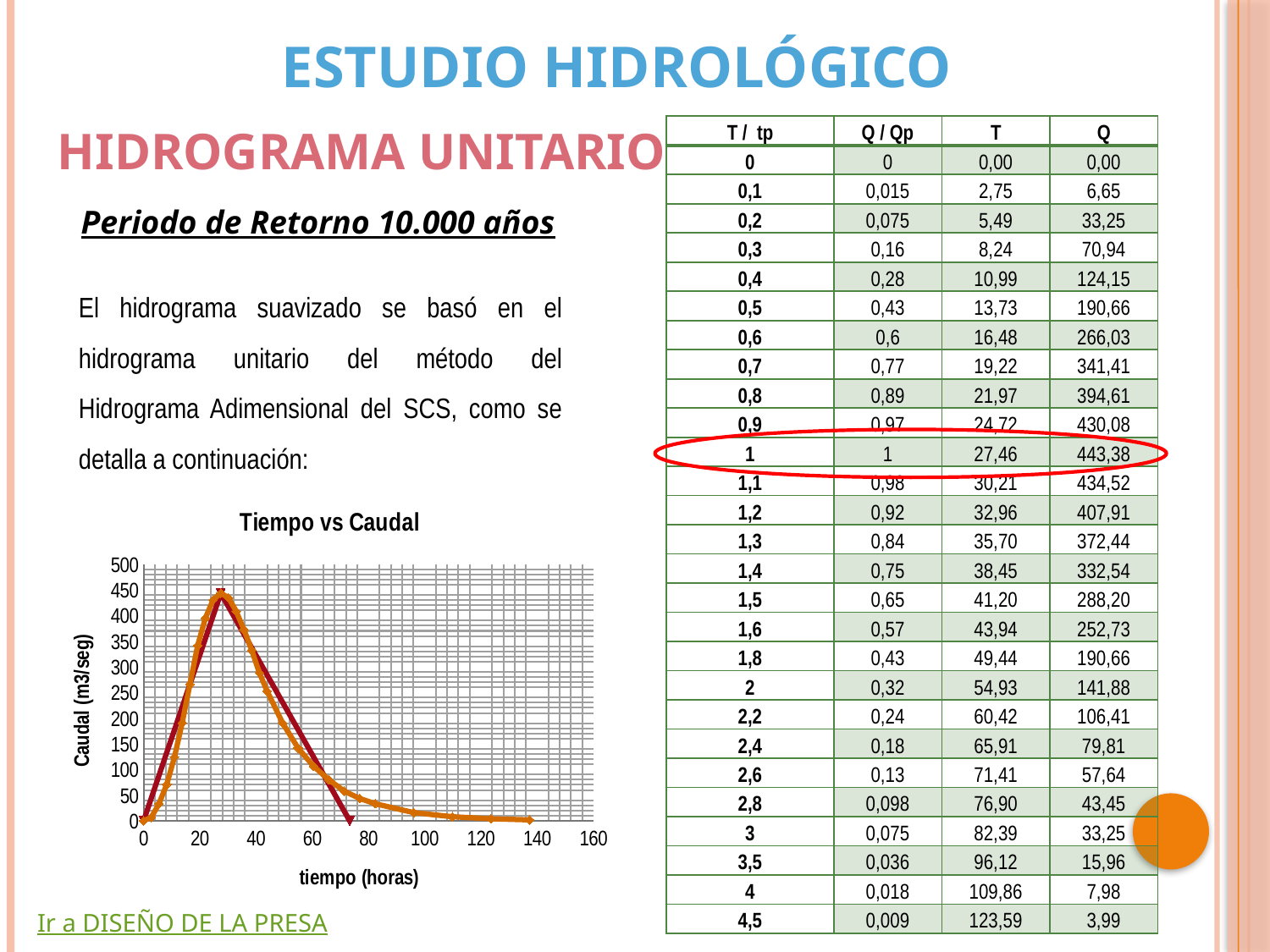
In the "Tiempo vs Caudal" chart, is the value of the orange curve at 100 hours greater or less than 50? less What is the highest tick value shown on the x axis of the "Tiempo vs Caudal" chart? 160 What kind of chart is "Tiempo vs Caudal"? line chart In the "Tiempo vs Caudal" chart, is the orange curve's value at 20 hours larger or smaller than its value at 80 hours? larger What is the title of the chart on the slide? Tiempo vs Caudal In the "Tiempo vs Caudal" chart, do the values of the orange curve rise or fall between 40 and 100 hours? fall In the "Tiempo vs Caudal" chart, is the value of the orange curve at 60 hours greater or less than 150? less In the "Tiempo vs Caudal" chart, is the peak value of the orange curve greater or less than 400? greater In the "Tiempo vs Caudal" chart, do the values of the orange curve rise or fall between 0 and 20 hours? rise What is the label of the y axis of the "Tiempo vs Caudal" chart? Caudal (m3/seg)